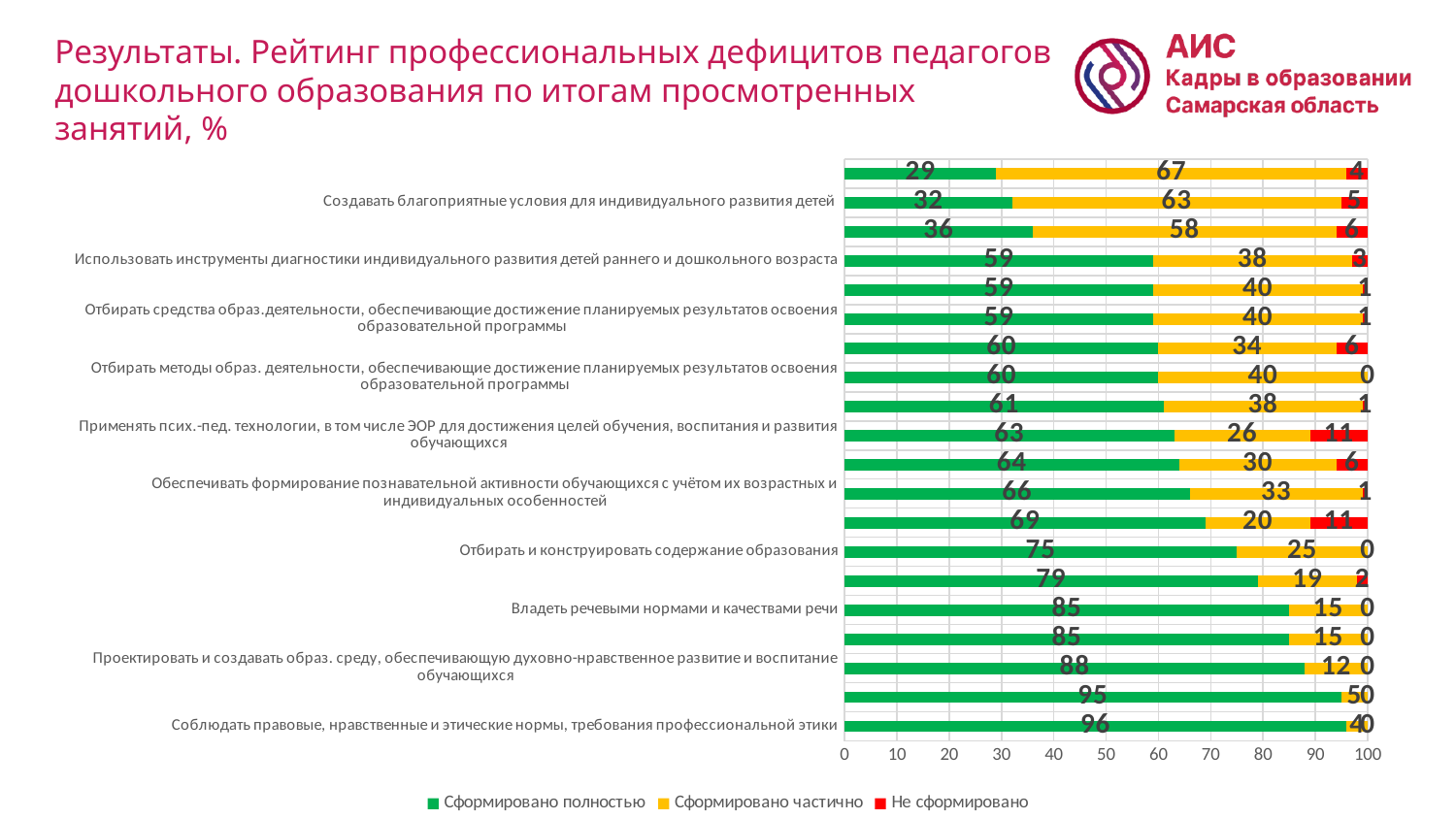
What is the value of 'Сформировано полностью' for 'Соблюдать правовые, нравственные и этические нормы, требования профессиональной этики'? 96 What type of chart is shown on the slide? bar chart Which labeled category has the highest value of 'Сформировано полностью'? Соблюдать правовые, нравственные и этические нормы, требования профессиональной этики What is the value of 'Не сформировано' for 'Применять псих.-пед. технологии, в том числе ЭОР для достижения целей обучения, воспитания и развития обучающихся'? 11 How many series does the legend list? 3 What is the difference in 'Сформировано полностью' between 'Соблюдать правовые, нравственные и этические нормы, требования профессиональной этики' and 'Создавать благоприятные условия для индивидуального развития детей'? 64 What is the lowest value of 'Сформировано полностью' shown in the chart? 29 Which has a larger 'Не сформировано' value: 'Применять псих.-пед. технологии, в том числе ЭОР для достижения целей обучения, воспитания и развития обучающихся' or 'Создавать благоприятные условия для индивидуального развития детей'? Применять псих.-пед. технологии, в том числе ЭОР для достижения целей обучения, воспитания и развития обучающихся What colour represents the 'Не сформировано' series in the legend? red How many bars are plotted in the chart? 20 What is the value of 'Сформировано полностью' for 'Владеть речевыми нормами и качеством речи'? 85 What is the value of 'Сформировано частично' for 'Создавать благоприятные условия для индивидуального развития детей'? 63